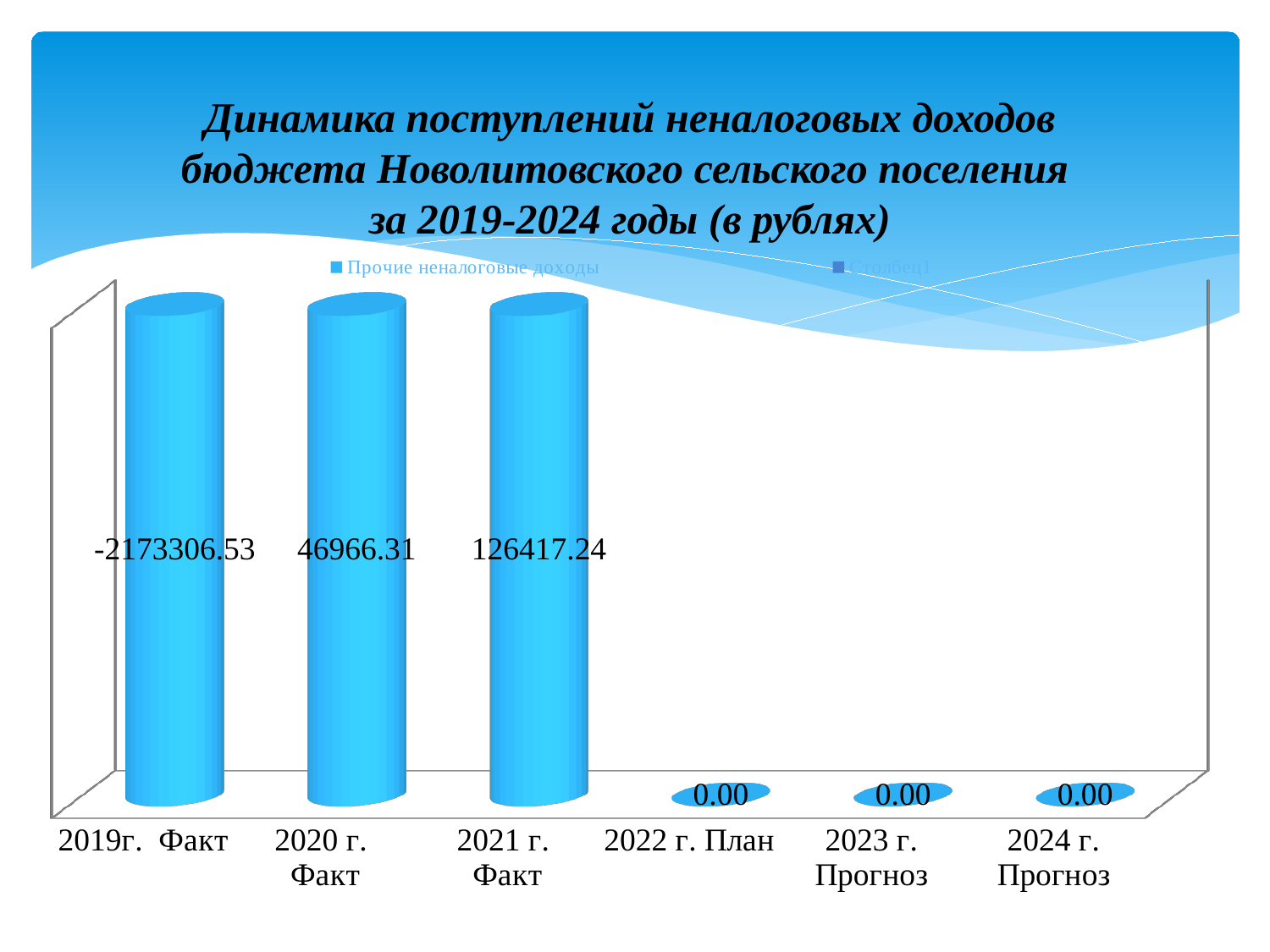
How many categories are shown on the x axis? 6 What is the value shown for 2020 г. Факт? 46966.31 What is the first legend entry of the chart? Прочие неналоговые доходы Which is larger, the value for 2020 г. Факт or the value for 2021 г. Факт? 2021 г. Факт What is the value shown for 2021 г. Факт? 126417.24 What is the value shown for 2022 г. План? 0.00 What is the value shown for 2019г. Факт? -2173306.53 What is the value shown for 2023 г. Прогноз? 0.00 What kind of chart is shown on the slide? Bar chart Which category has the highest labelled value? 2021 г. Факт How many series does the legend list? 2 What is the difference between the values for 2021 г. Факт and 2020 г. Факт? 79450.93